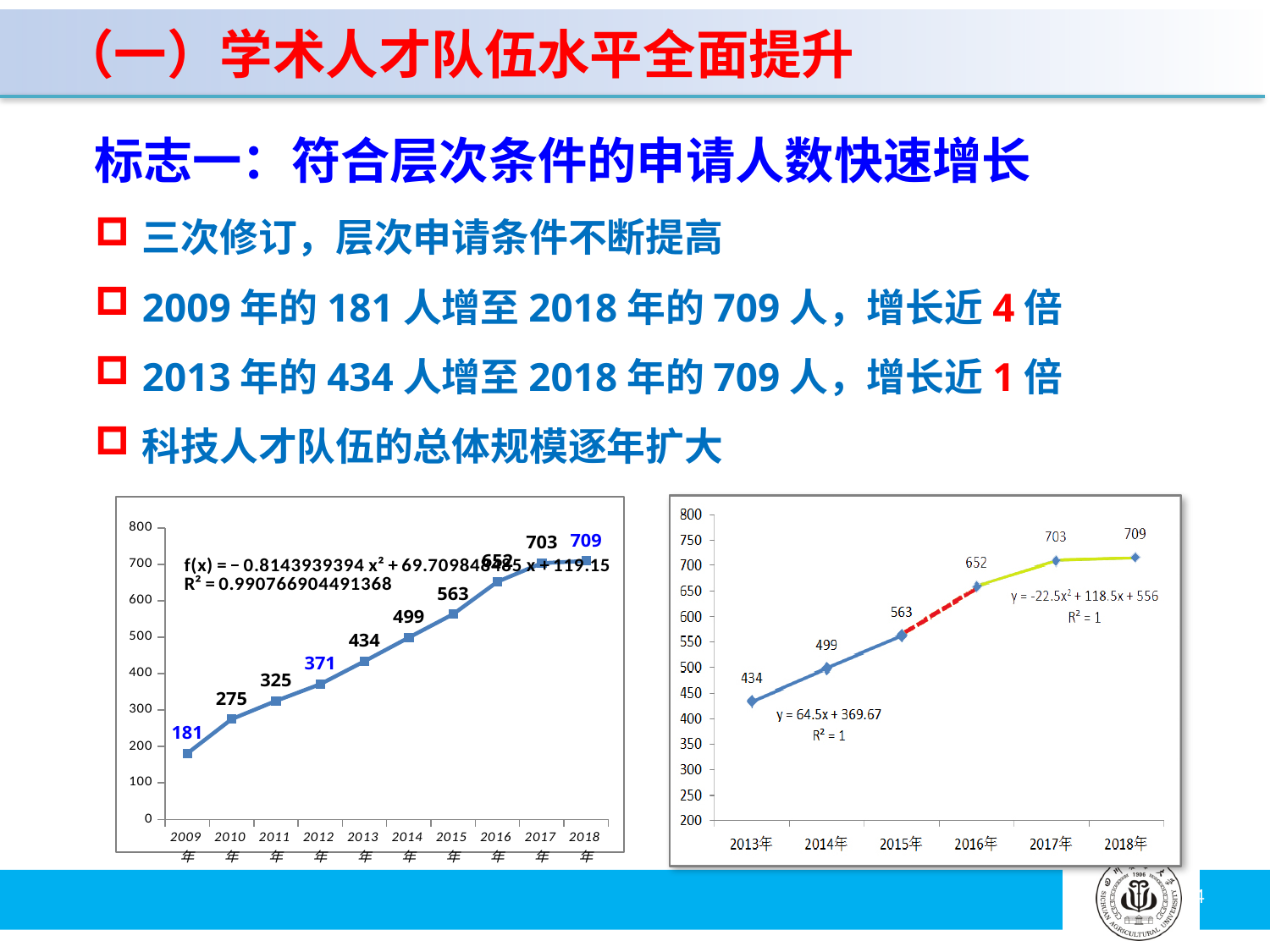
In the left chart, which year has the lowest value? 2009年 In the left chart, how many years are plotted on the x axis? 10 In the right chart, how many data points are plotted? 6 In the right chart, which is larger, the value for 2014年 or the value for 2015年? 2015年 In the left chart, do the values rise or fall from 2009年 to 2018年? rise In the left chart, what is the value for 2009年? 181 In the left chart, which year has the highest value? 2018年 In the left chart, what is the difference between the values for 2018年 and 2009年? 528 In the left chart, what is the value for 2012年? 371 In the right chart, what is the value for 2016年? 652 In the right chart, what is the difference between the values for 2018年 and 2013年? 275 What kind of chart is the left chart? line chart